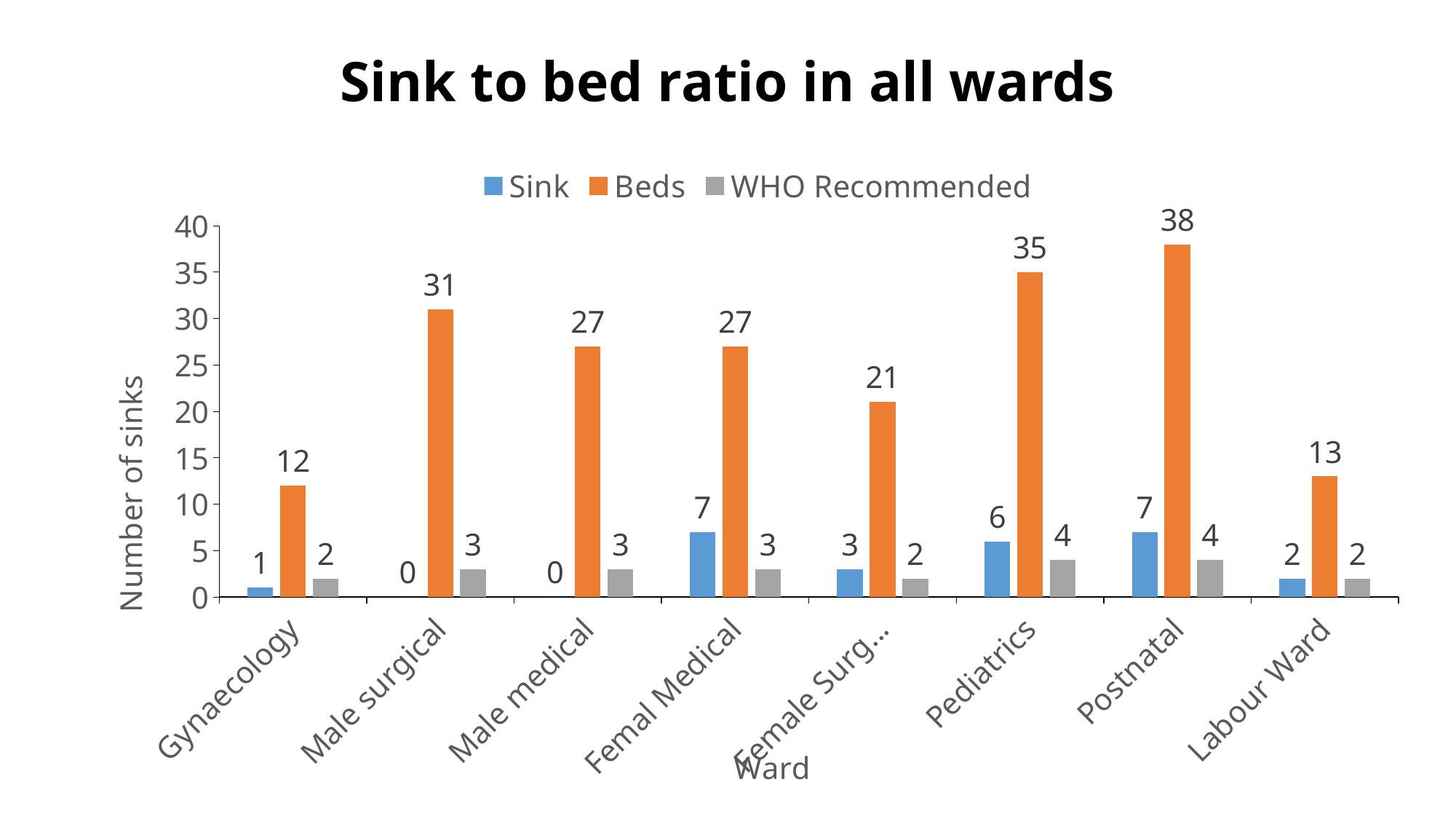
What is the difference between the Beds value and the Sink value for Male surgical? 31 What is the title of the chart? Sink to bed ratio in all wards How many wards are shown on the x axis? 8 Which is larger, the Sink value for Pediatrics or the Sink value for Postnatal? Postnatal How many beds does the Postnatal ward have? 38 How many series does the legend list? 3 Which ward has the highest number of beds? Postnatal What is the difference between the Beds values for Pediatrics and Labour Ward? 22 What kind of chart is shown on the slide? Bar chart What is the Sink value for the Femal Medical ward? 7 What is the WHO Recommended value for Pediatrics? 4 Which ward has the lowest number of beds? Gynaecology